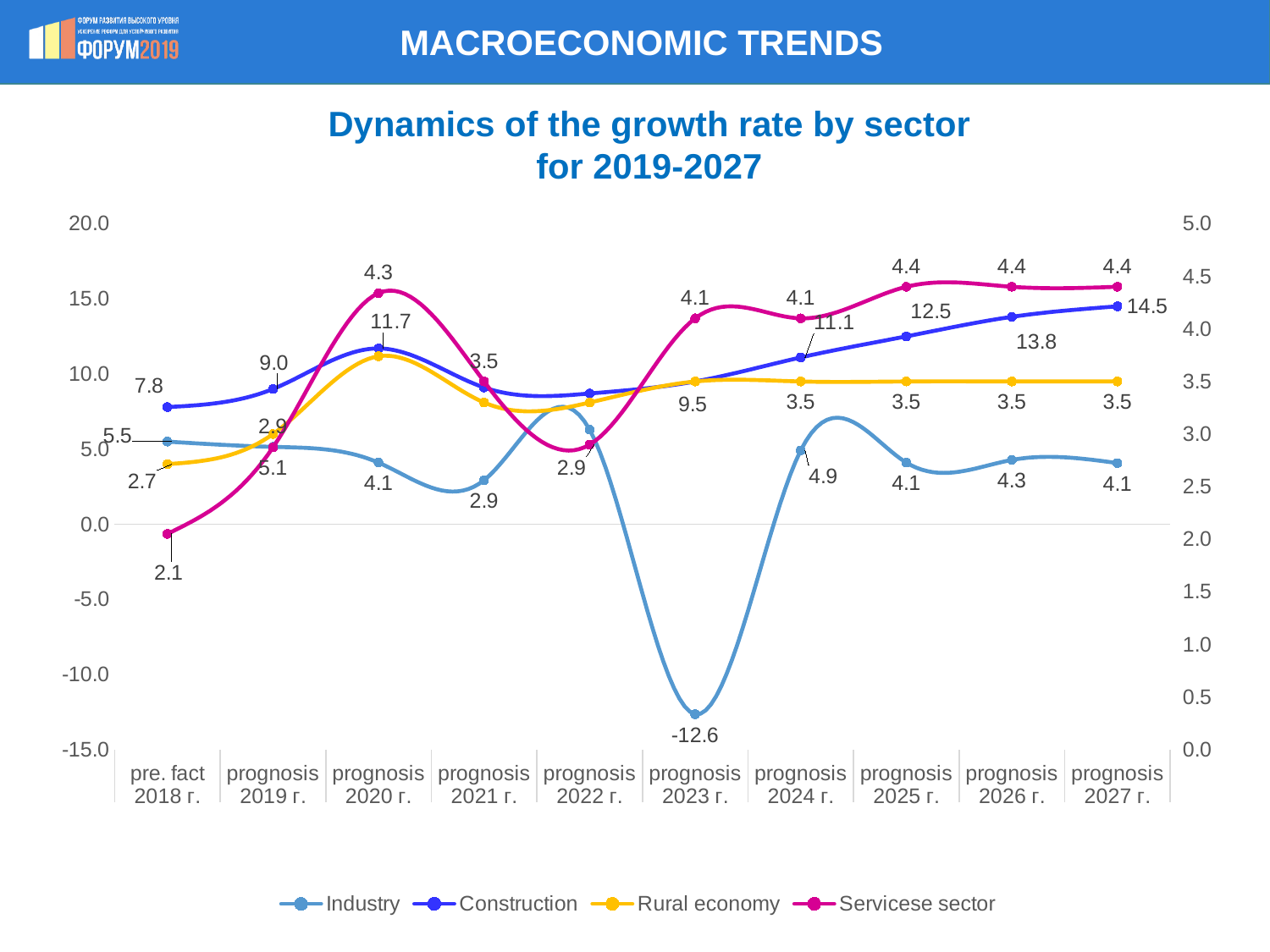
How many time periods are shown along the x axis? 10 In which period does Industry reach its lowest value? prognosis 2023 г. What is the difference between the Construction value in prognosis 2027 (14.5) and in pre. fact 2018 (7.8)? 6.7 What is the value for Industry in prognosis 2023? -12.6 In which period does Construction reach its highest value? prognosis 2027 г. What type of chart is shown on the slide? line chart Which is larger for Industry: the value in prognosis 2024 or in prognosis 2025? prognosis 2024 Does the Construction line rise or fall from prognosis 2023 to prognosis 2027? rise What is the value for Industry in prognosis 2024? 4.9 How many series does the legend list? 4 What is the value for Servicese sector in prognosis 2020? 4.3 What is the value for Construction in prognosis 2027? 14.5